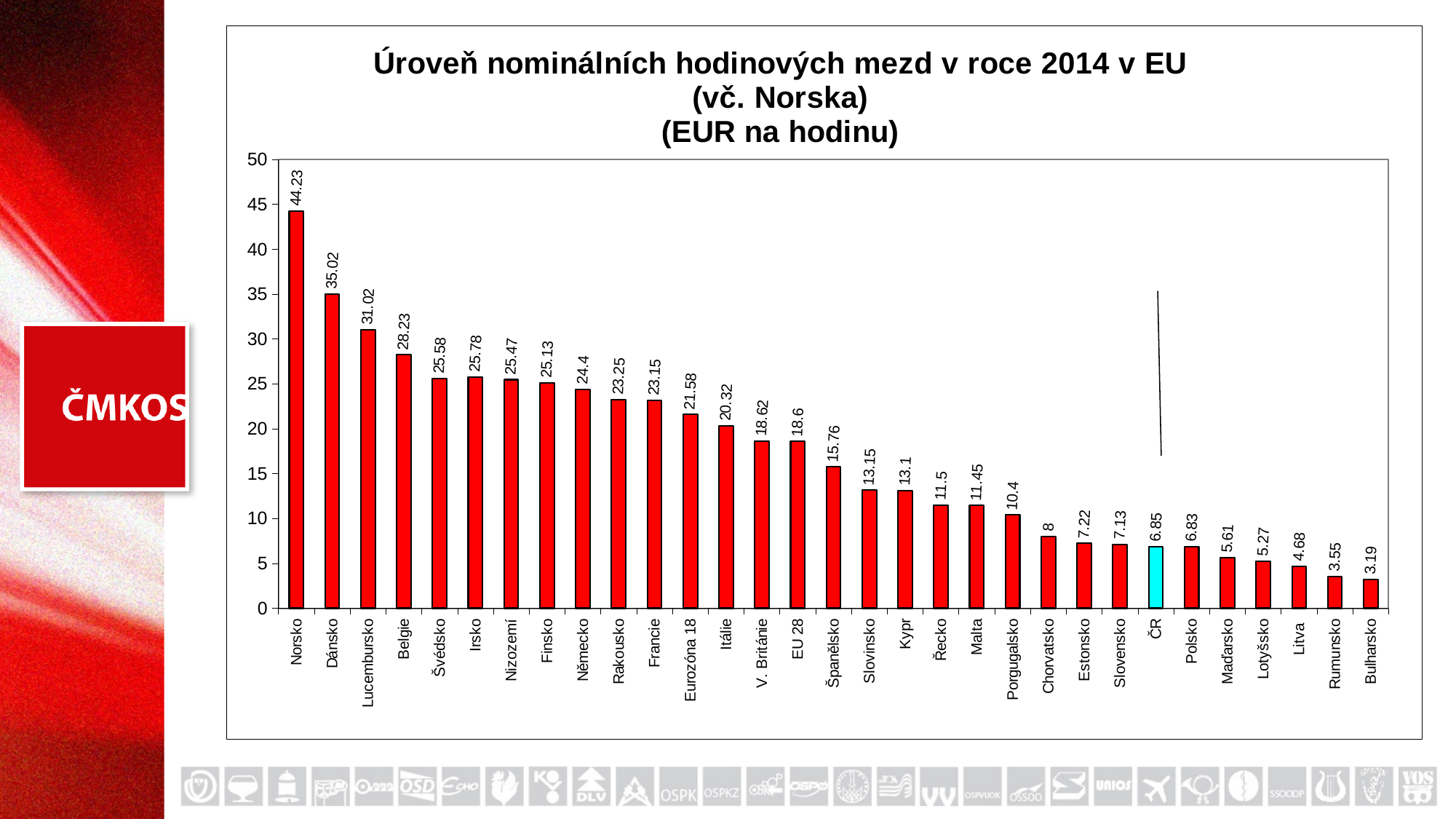
What is the value for EU 28? 18.6 Which has a larger value, Dánsko or Lucembursko? Dánsko Which country has the highest nominal hourly wage in the chart? Norsko What is the value for ČR? 6.85 What is the difference between the values for Norsko and Bulharsko? 41.04 What type of chart is shown on the slide? bar chart What is the difference between the values for EU 28 and ČR? 11.75 Do the values rise or fall from left to right along the x axis? fall Which bar is coloured differently (cyan) from the others? ČR What is the value for Norsko? 44.23 Which country has the lowest nominal hourly wage in the chart? Bulharsko How many categories are plotted on the x axis? 31